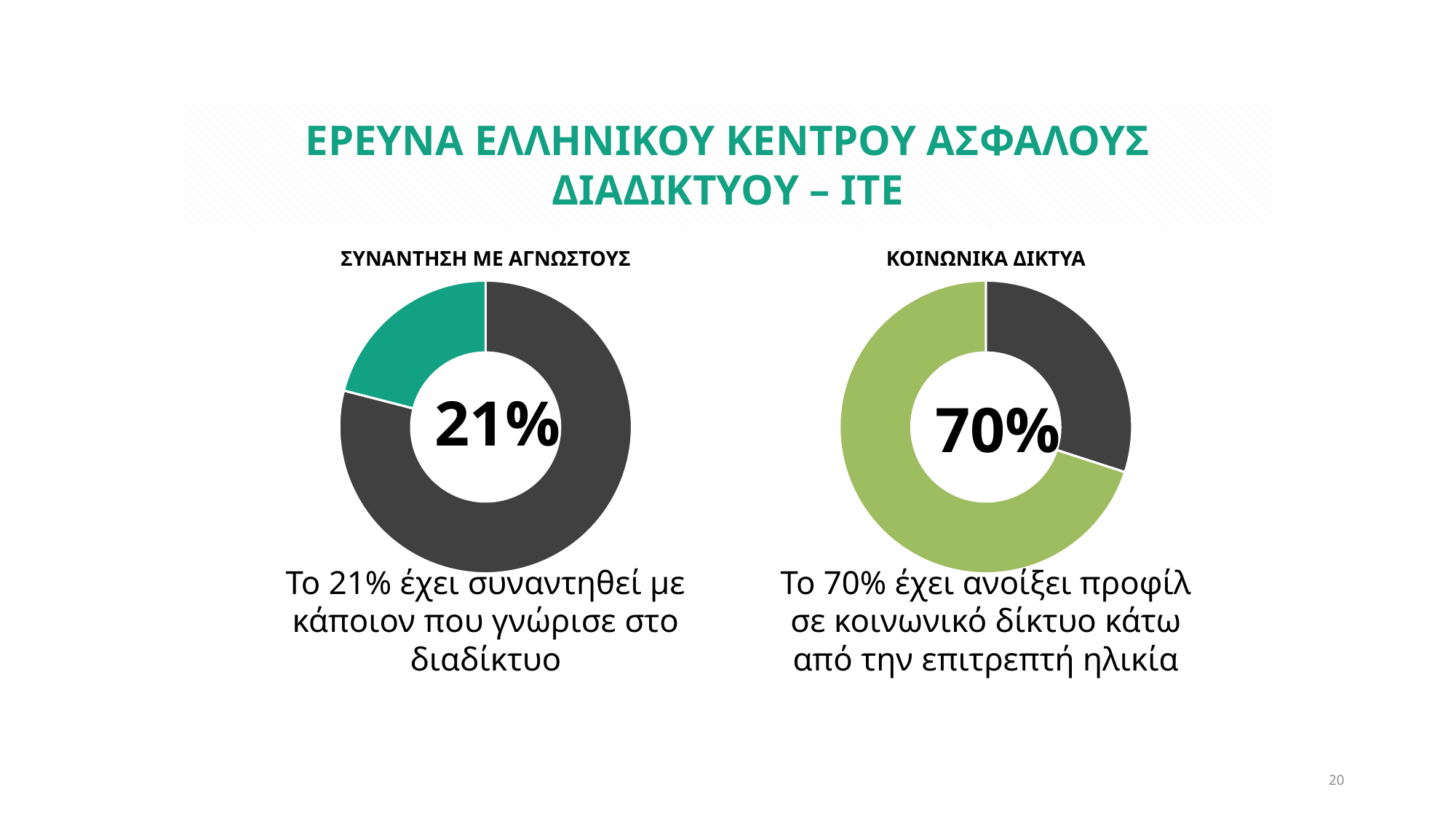
In the "ΚΟΙΝΩΝΙΚΑ ΔΙΚΤΥΑ" chart, is the green slice larger or smaller than the grey slice? Larger What kind of chart is the "ΚΟΙΝΩΝΙΚΑ ΔΙΚΤΥΑ" chart? Doughnut (pie) chart What colour is the 70% slice in the "ΚΟΙΝΩΝΙΚΑ ΔΙΚΤΥΑ" chart? Green In the "ΣΥΝΑΝΤΗΣΗ ΜΕ ΑΓΝΩΣΤΟΥΣ" chart, what percentage is printed in the centre? 21% In the "ΣΥΝΑΝΤΗΣΗ ΜΕ ΑΓΝΩΣΤΟΥΣ" chart, is the highlighted (teal) slice larger or smaller than the grey slice? Smaller How many slices does the "ΚΟΙΝΩΝΙΚΑ ΔΙΚΤΥΑ" chart have? 2 How many slices does the "ΣΥΝΑΝΤΗΣΗ ΜΕ ΑΓΝΩΣΤΟΥΣ" chart have? 2 What kind of chart is the "ΣΥΝΑΝΤΗΣΗ ΜΕ ΑΓΝΩΣΤΟΥΣ" chart? Doughnut (pie) chart Which chart shows the larger highlighted percentage, "ΣΥΝΑΝΤΗΣΗ ΜΕ ΑΓΝΩΣΤΟΥΣ" or "ΚΟΙΝΩΝΙΚΑ ΔΙΚΤΥΑ"? ΚΟΙΝΩΝΙΚΑ ΔΙΚΤΥΑ What is the title of the chart on the left of the slide? ΣΥΝΑΝΤΗΣΗ ΜΕ ΑΓΝΩΣΤΟΥΣ What is the difference between the percentage shown in the "ΚΟΙΝΩΝΙΚΑ ΔΙΚΤΥΑ" chart and the percentage shown in the "ΣΥΝΑΝΤΗΣΗ ΜΕ ΑΓΝΩΣΤΟΥΣ" chart? 49% In the "ΚΟΙΝΩΝΙΚΑ ΔΙΚΤΥΑ" chart, what percentage is printed in the centre? 70%